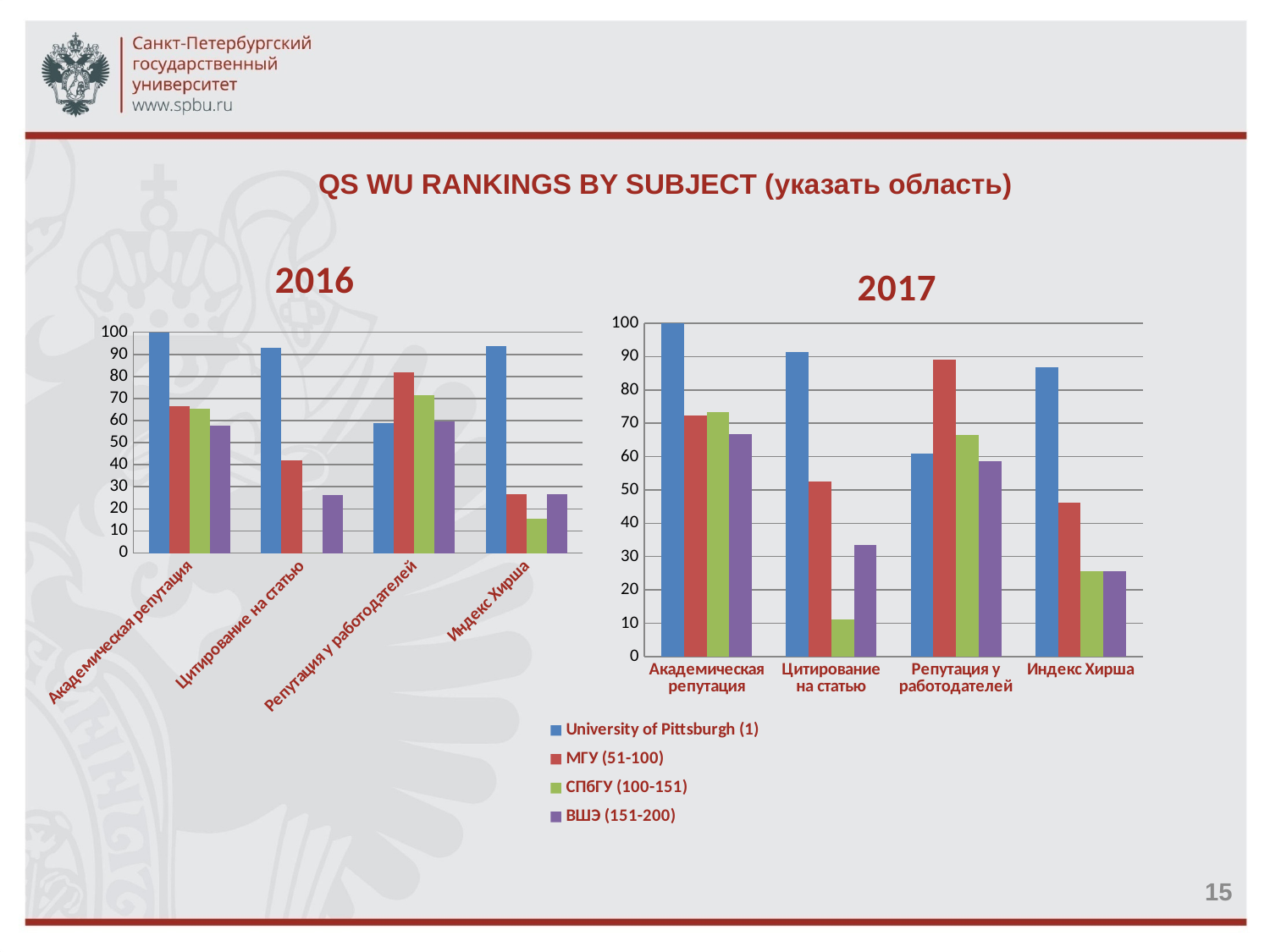
In the 2017 chart, what is the value for University of Pittsburgh (1) in Академическая репутация? 100 In the 2017 chart, is the value for МГУ (51-100) in Репутация у работодателей greater or less than 80? greater How many categories are shown on the x axis of the 2016 chart? 4 In the 2016 chart, is the value for СПбГУ (100-151) in Индекс Хирша greater or less than 20? less In the 2016 chart, which is larger in Цитирование на статью: МГУ (51-100) or ВШЭ (151-200)? МГУ (51-100) How many series does the legend list? 4 In the 2016 chart, which series has the highest value in Репутация у работодателей? МГУ (51-100) In the 2017 chart, which series has the lowest value in Цитирование на статью? СПбГУ (100-151) Which series is shown in blue in the legend? University of Pittsburgh (1) In the 2017 chart, which is larger in Индекс Хирша: University of Pittsburgh (1) or МГУ (51-100)? University of Pittsburgh (1) What kind of chart is the 2017 chart? bar chart How many charts are on the slide? 2